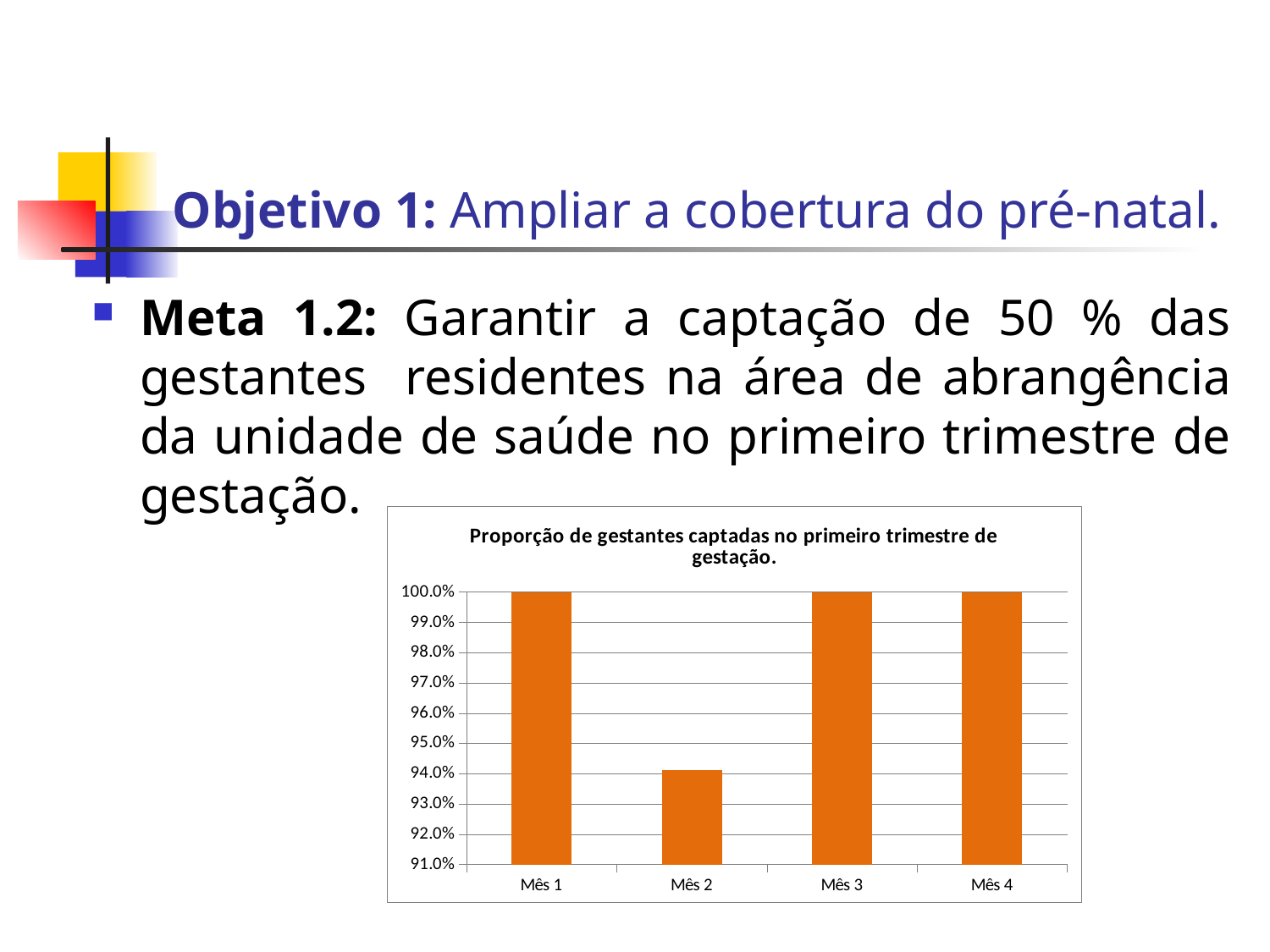
What kind of chart is shown on the slide? bar chart Which month has the lowest value in the chart? Mês 2 What is the value for Mês 3 in the chart? 100.0% Is the value for Mês 2 greater or less than 93.0%? greater Is the value for Mês 2 greater or less than 95.0%? less What colour are the bars in the chart? orange What is the value for Mês 4 in the chart? 100.0% What is the title of the chart? Proporção de gestantes captadas no primeiro trimestre de gestação. Which is larger, the value for Mês 1 or the value for Mês 2? Mês 1 How many months in the chart reach 100.0%? 3 How many months (categories) are shown on the x axis of the chart? 4 What is the value for Mês 1 in the chart? 100.0%